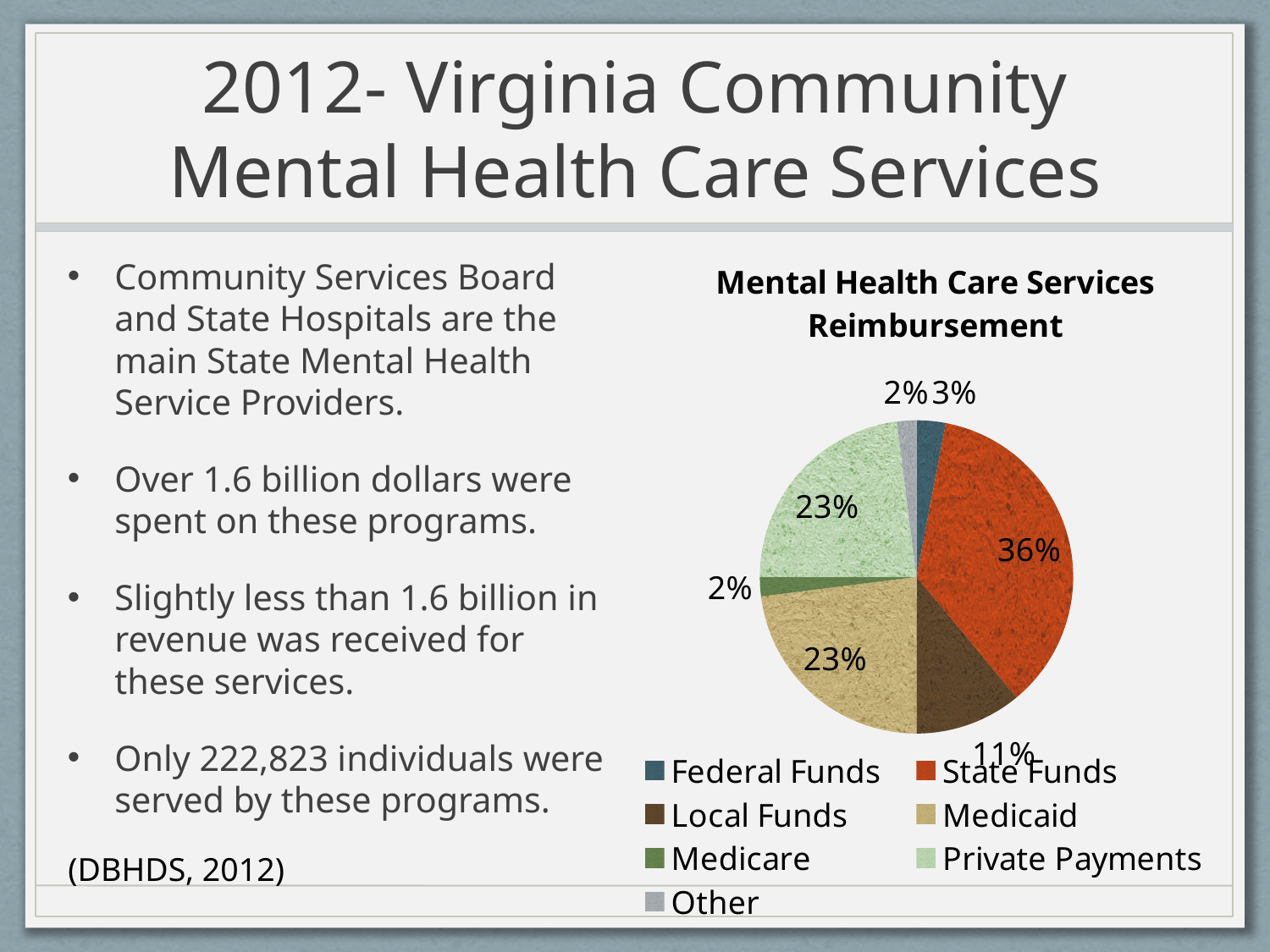
What percentage of reimbursement comes from Medicaid? 23% What percentage of reimbursement comes from Federal Funds? 3% What is the combined share of Medicaid and Private Payments? 46% Which is larger, the share for State Funds or the share for Private Payments? State Funds What is the title of the chart? Mental Health Care Services Reimbursement What percentage of reimbursement comes from Private Payments? 23% What kind of chart is shown on the slide? pie chart How many categories does the legend of the pie chart list? 7 What percentage of reimbursement comes from Local Funds? 11% What is the difference in percentage points between State Funds and Local Funds? 25 What percentage of reimbursement comes from State Funds? 36% Which category has the largest share of the pie? State Funds